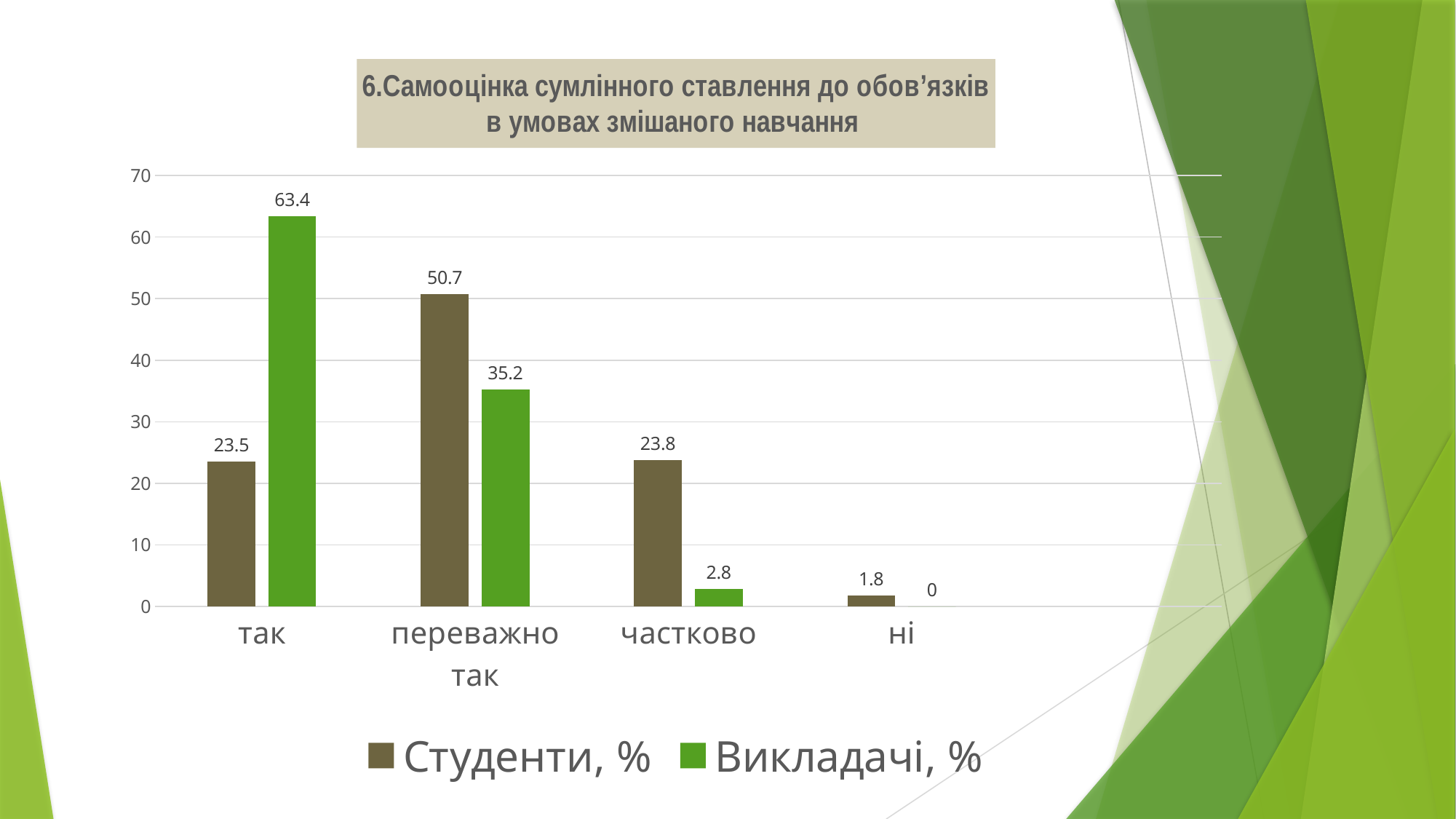
Which is larger in the category "частково": Студенти, % or Викладачі, %? Студенти, % What is the value for Викладачі, % in the category "переважно так"? 35.2 How many categories are shown on the x axis? 4 What kind of chart is shown on the slide? bar chart Which category has the lowest value for Студенти, %? ні Which category has the highest value for Викладачі, %? так Is the value for Студенти, % in "переважно так" greater or less than 40? greater What is the value for Студенти, % in the category "так"? 23.5 How many series does the legend list? 2 What is the value for Викладачі, % in the category "ні"? 0 What colour are the bars for Викладачі, %? green What is the difference between Викладачі, % and Студенти, % in the category "так"? 39.9